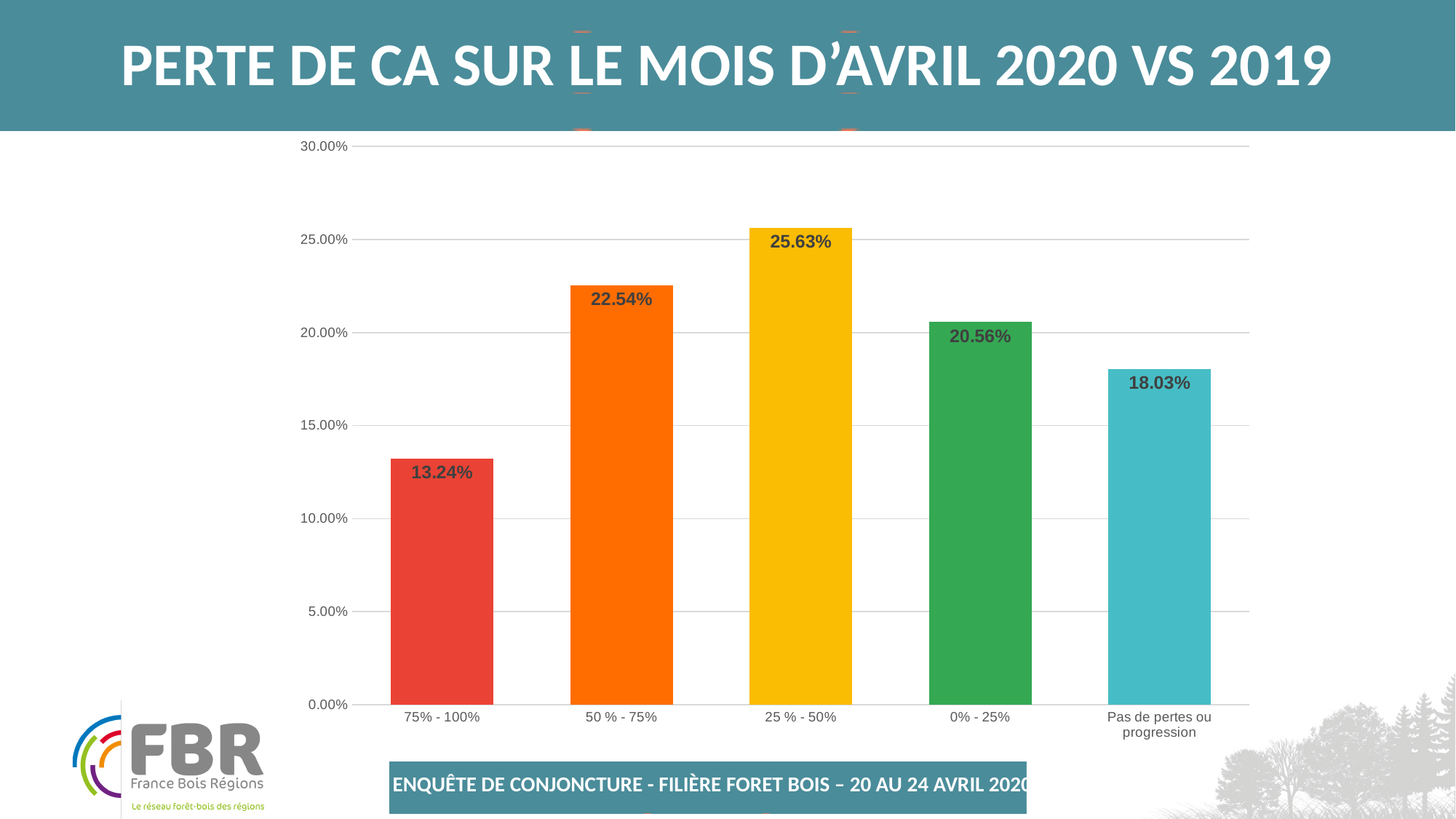
What is the value for "Pas de pertes ou progression"? 18.03% Which category has the lowest value? 75% - 100% What is the title of the slide? PERTE DE CA SUR LE MOIS D'AVRIL 2020 VS 2019 Which category has the highest value? 25 % - 50% How many categories are shown on the x axis? 5 What is the value for the "25 % - 50%" category? 25.63% What kind of chart is shown on the slide? bar chart What is the value for the "75% - 100%" category? 13.24% What colour is the bar for the "25 % - 50%" category? yellow Which is larger, the value for "0% - 25%" or the value for "Pas de pertes ou progression"? 0% - 25% Is the value for "50 % - 75%" greater or less than 20.00%? greater What is the difference between the values for "50 % - 75%" and "0% - 25%"? 1.98%